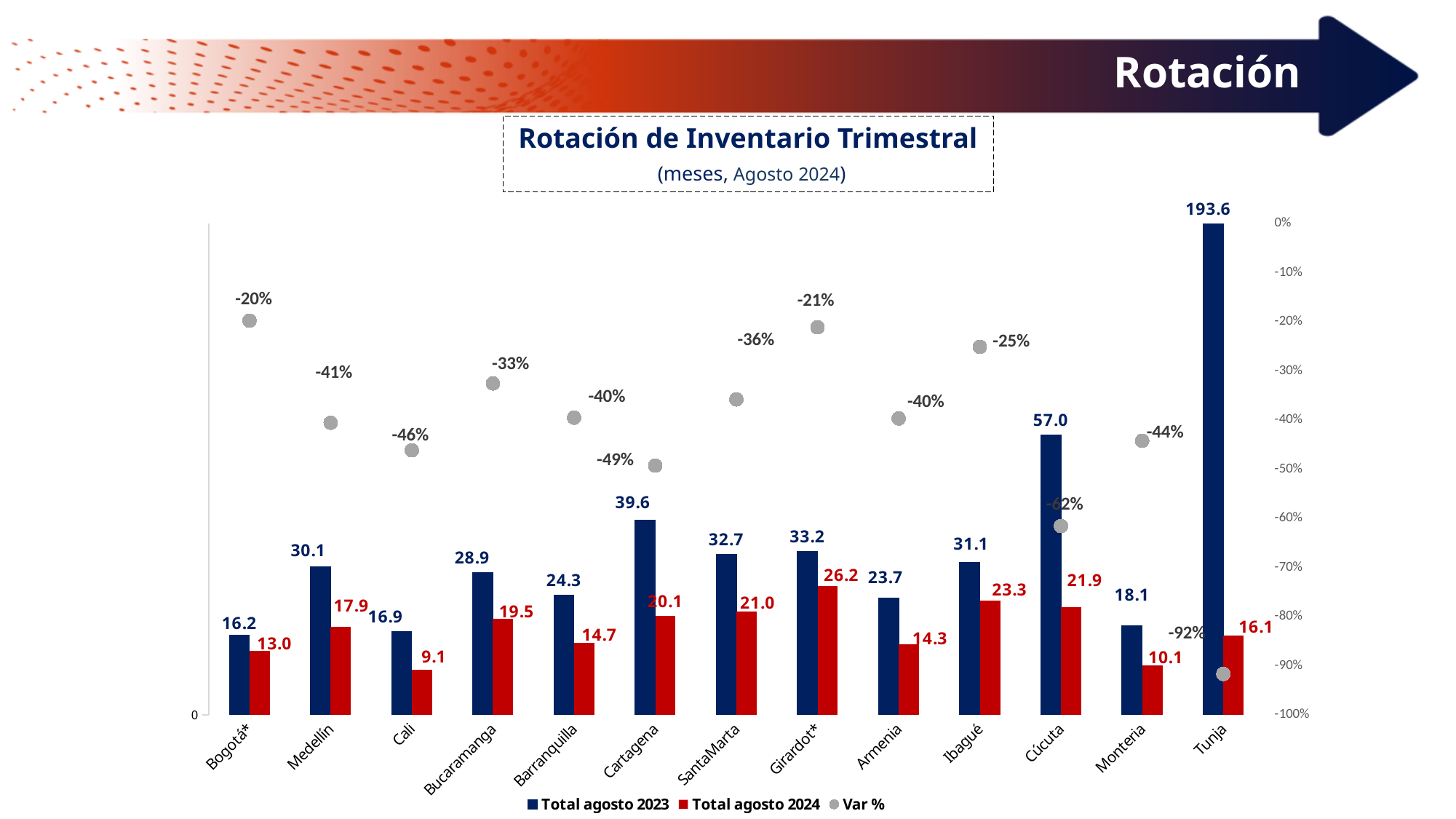
How many series does the legend list? 3 Which city has the lowest Total agosto 2024 value? Cali Which is larger: the Total agosto 2024 value for Ibagué or for SantaMarta? Ibagué What is the Var % value for Tunja? -92% What is the Total agosto 2023 value for Cúcuta? 57.0 Which city has the highest Total agosto 2023 value? Tunja How many cities are shown on the x axis? 13 What is the subtitle shown under the chart title 'Rotación de Inventario Trimestral'? (meses, Agosto 2024) What kind of chart is used for the Total agosto 2023 and Total agosto 2024 series? Bar chart What is the difference between the Total agosto 2023 and Total agosto 2024 values for Medellín? 12.2 What is the Var % value for Bogotá*? -20% What is the Total agosto 2024 value for Girardot*? 26.2